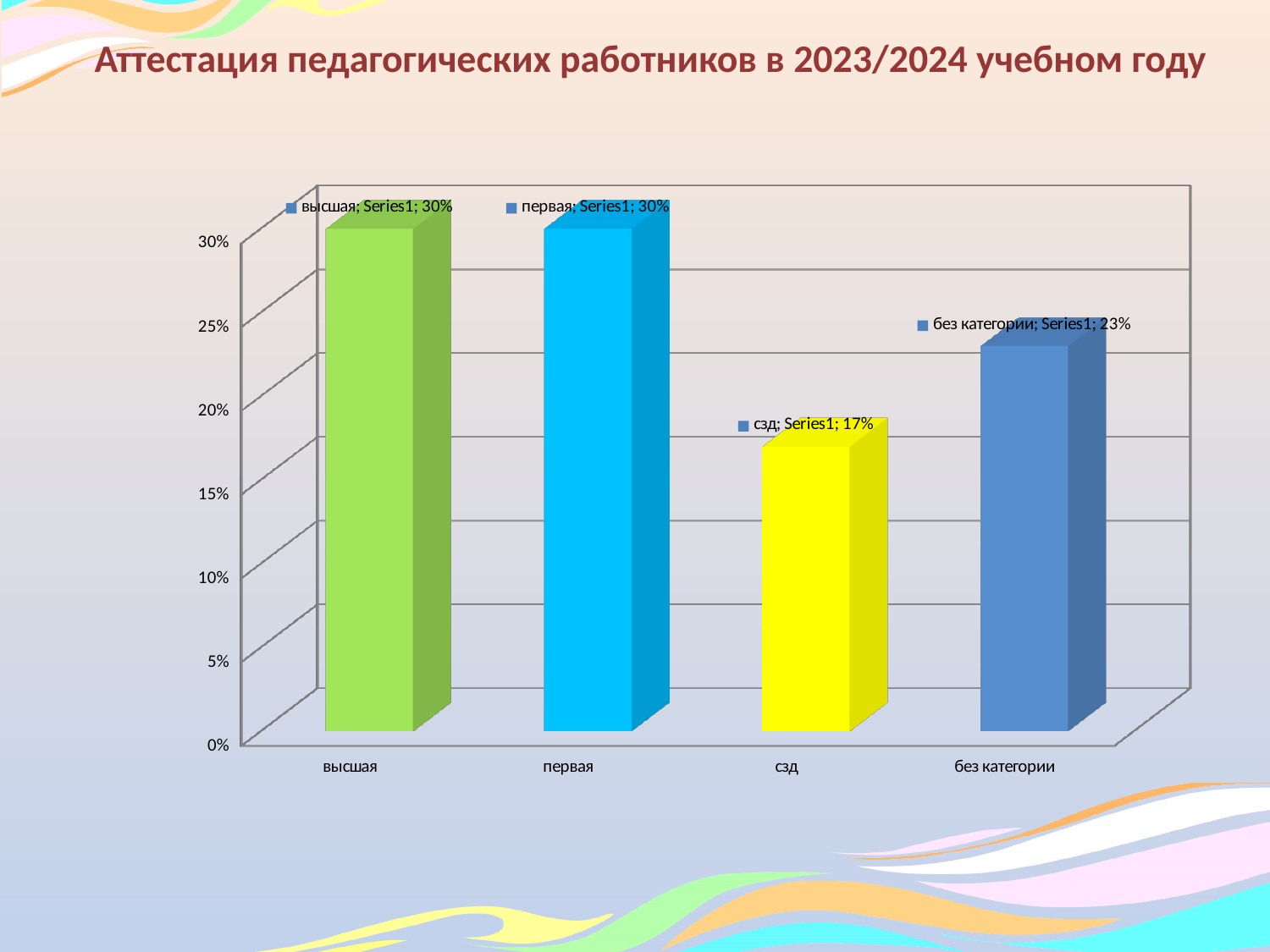
What is the value for сзд? 17% What is the difference between the values for высшая and сзд? 13% Is the value for сзд greater or less than 20%? less What is the title of the slide? Аттестация педагогических работников в 2023/2024 учебном году What kind of chart is shown on the slide? bar chart What is the value for высшая? 30% How many categories are shown on the x axis? 4 Which is larger, the value for без категории or the value for сзд? без категории Which category has the lowest value? сзд What is the value for первая? 30% What is the difference between the values for без категории and сзд? 6% What is the value for без категории? 23%